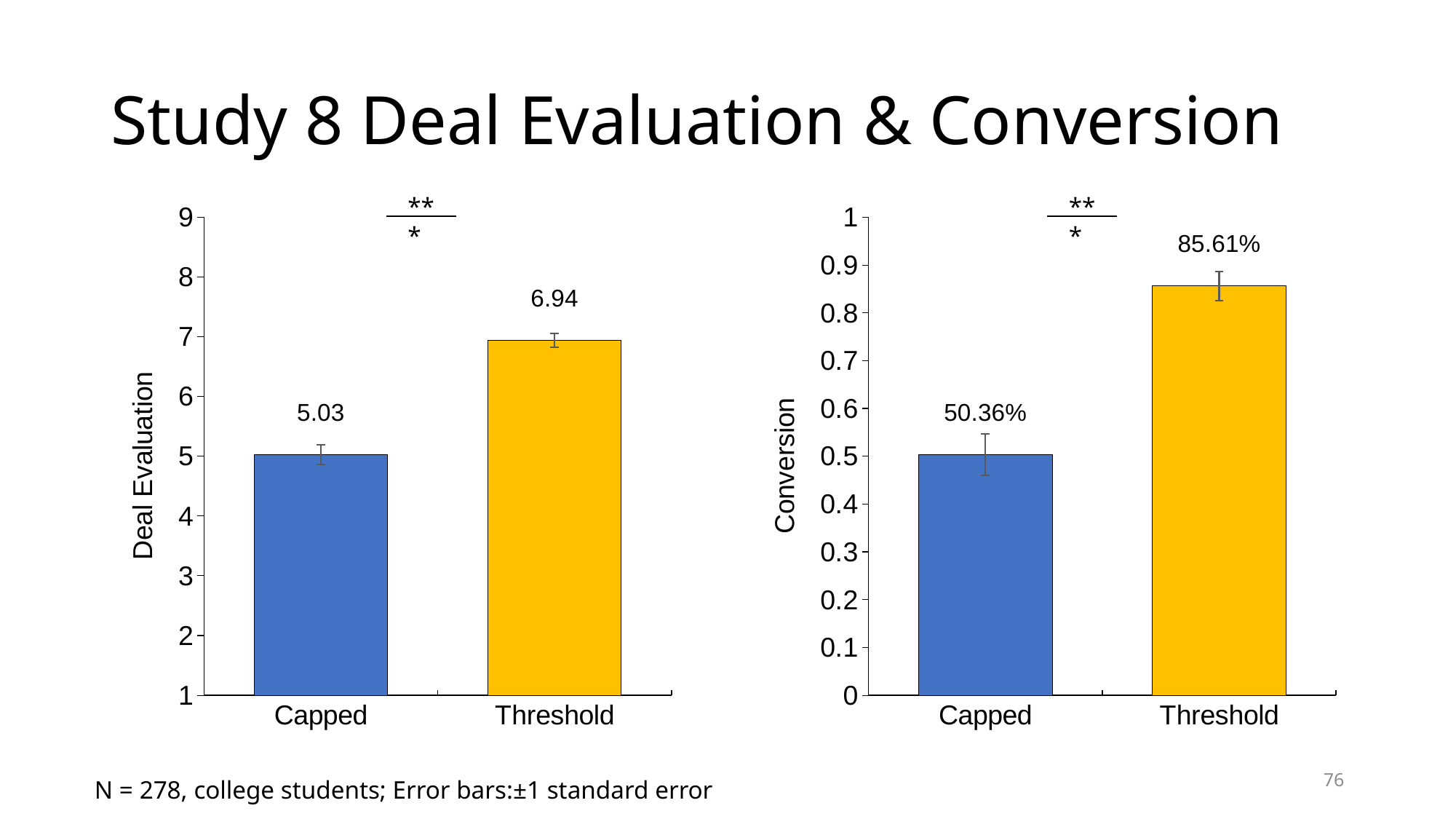
In the Conversion chart on the right, what is the difference between the Threshold and Capped values? 35.25% What is the y-axis label of the chart on the left? Deal Evaluation In the Deal Evaluation chart on the left, which category has the higher value? Threshold In the Deal Evaluation chart on the left, what is the difference between the Threshold and Capped values? 1.91 In the Conversion chart on the right, what is the value for Capped? 50.36% In the Conversion chart on the right, is the value for Capped greater or less than 0.6? less In the Conversion chart on the right, which category has the lowest value? Capped In the Conversion chart on the right, what is the value for Threshold? 85.61% How many categories are shown in the Deal Evaluation chart on the left? 2 In the Deal Evaluation chart on the left, what is the value for Capped? 5.03 In the Deal Evaluation chart on the left, what is the value for Threshold? 6.94 What kind of chart is the Conversion chart on the right? bar chart